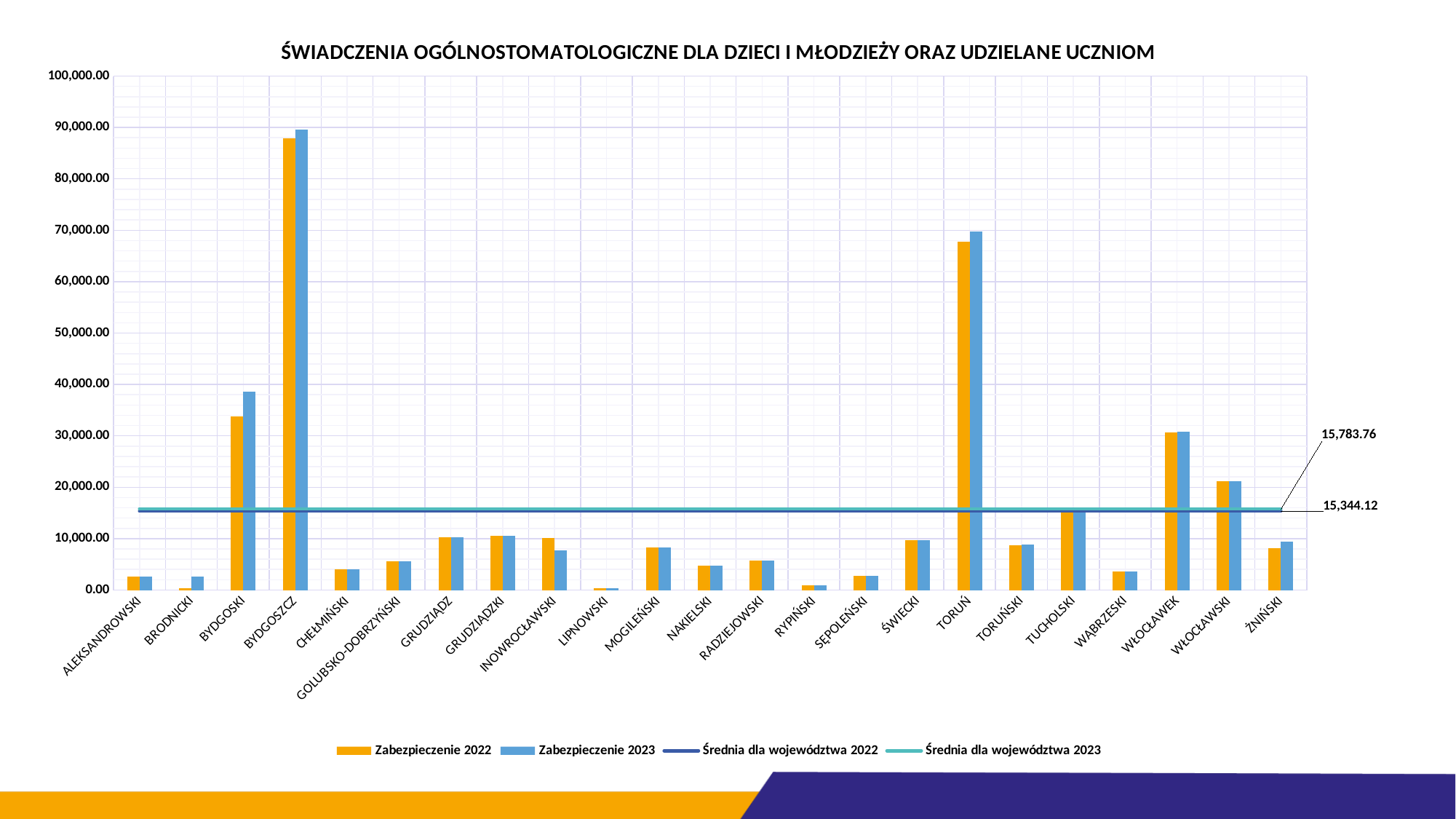
What colour are the bars for Zabezpieczenie 2022? orange Which has the larger Zabezpieczenie 2023 value, BYDGOSZCZ or TORUŃ? BYDGOSZCZ How many series does the legend list? 4 Is the Zabezpieczenie 2023 value for BYDGOSKI greater or less than 30,000.00? greater For INOWROCŁAWSKI, which is larger: Zabezpieczenie 2022 or Zabezpieczenie 2023? Zabezpieczenie 2022 Is the Zabezpieczenie 2022 value for TORUŃ greater or less than 60,000.00? greater Which category has the lowest value for Zabezpieczenie 2023? LIPNOWSKI How many categories (powiaty/cities) are shown on the x axis? 23 For BYDGOSKI, which is larger: Zabezpieczenie 2022 or Zabezpieczenie 2023? Zabezpieczenie 2023 What kind of chart is shown on the slide? combination bar and line chart Which category has the highest value for Zabezpieczenie 2023? BYDGOSZCZ Is the Zabezpieczenie 2022 value for WŁOCŁAWEK greater or less than 40,000.00? less